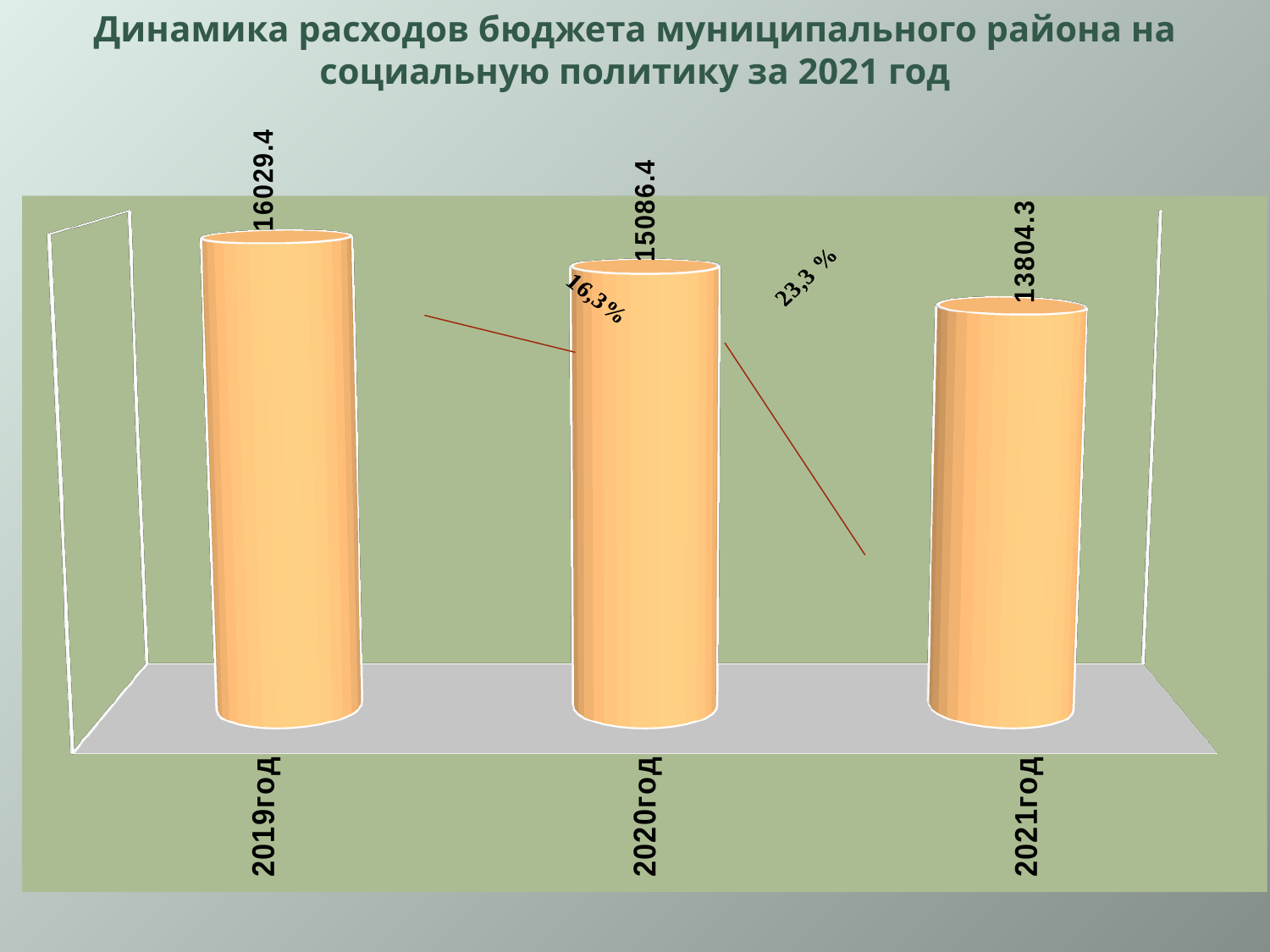
Which year has the highest value? 2019год What is the difference between the values for 2019год and 2021год? 2225.1 What is the difference between the values for 2020год and 2021год? 1282.1 What kind of chart is shown on the slide? Bar chart What is the value shown for 2020год? 15086.4 Which is larger, the value for 2020год or the value for 2021год? 2020год What is the value shown for 2019год? 16029.4 Which year has the lowest value? 2021год What is the value shown for 2021год? 13804.3 What is the difference between the values for 2019год and 2020год? 943.0 How many years are shown on the chart? 3 Do the values rise or fall from 2019год to 2021год? Fall